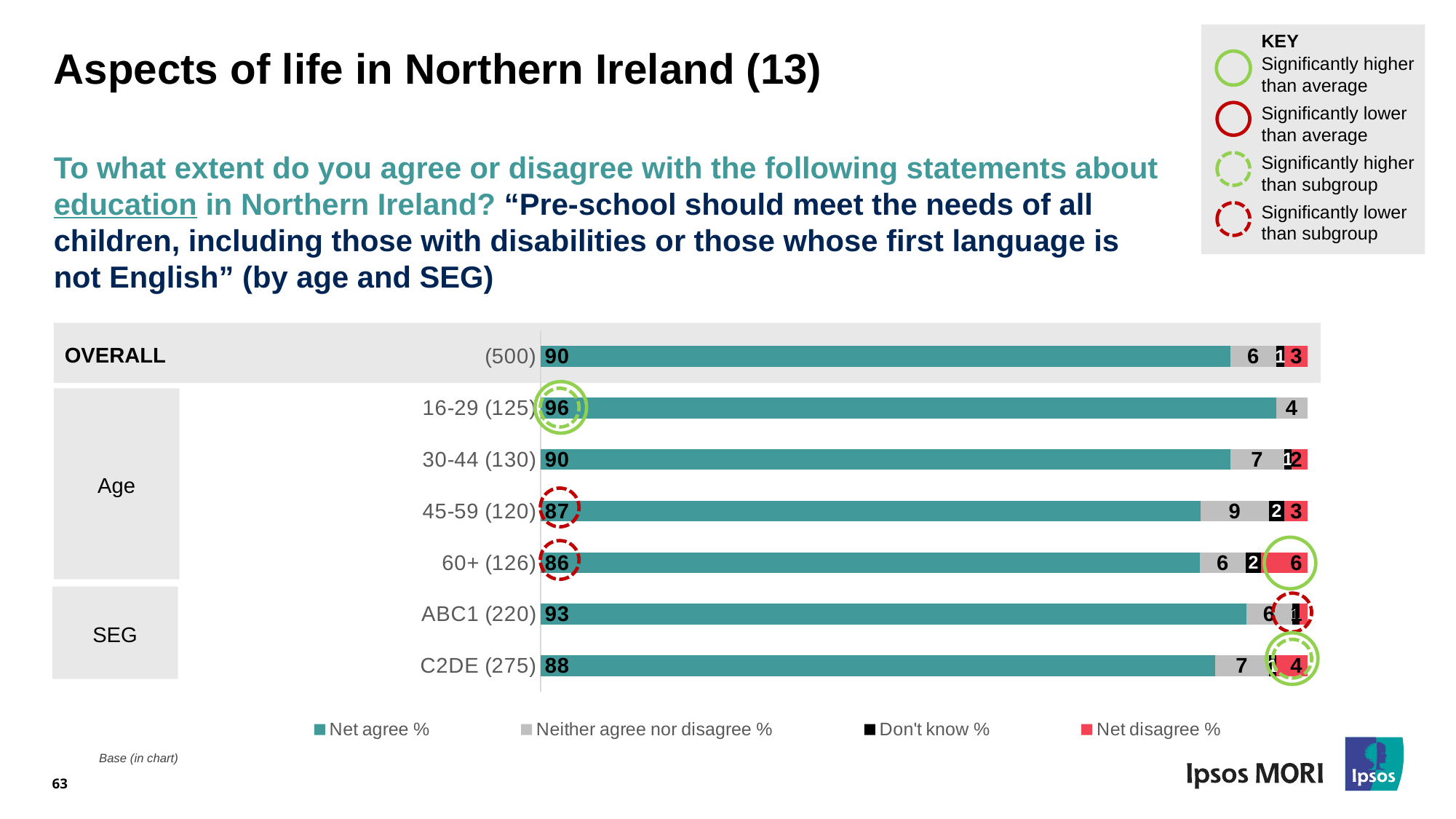
Which group has the highest Net agree %? 16-29 What is the Neither agree nor disagree % for the 45-59 group? 9 What is the base size shown for the C2DE group? 275 What is the Net agree % for OVERALL? 90 What is the Net agree % for ABC1? 93 How many series does the legend list? 4 Which has a higher Net agree %, ABC1 or C2DE? ABC1 What is the difference in Net agree % between the 16-29 group and the 60+ group? 10 Which group has the lowest Net agree %? 60+ What kind of chart is shown on the slide? Stacked bar chart What is the Net disagree % for the 60+ group? 6 How many groups (bars) are shown in the chart? 7